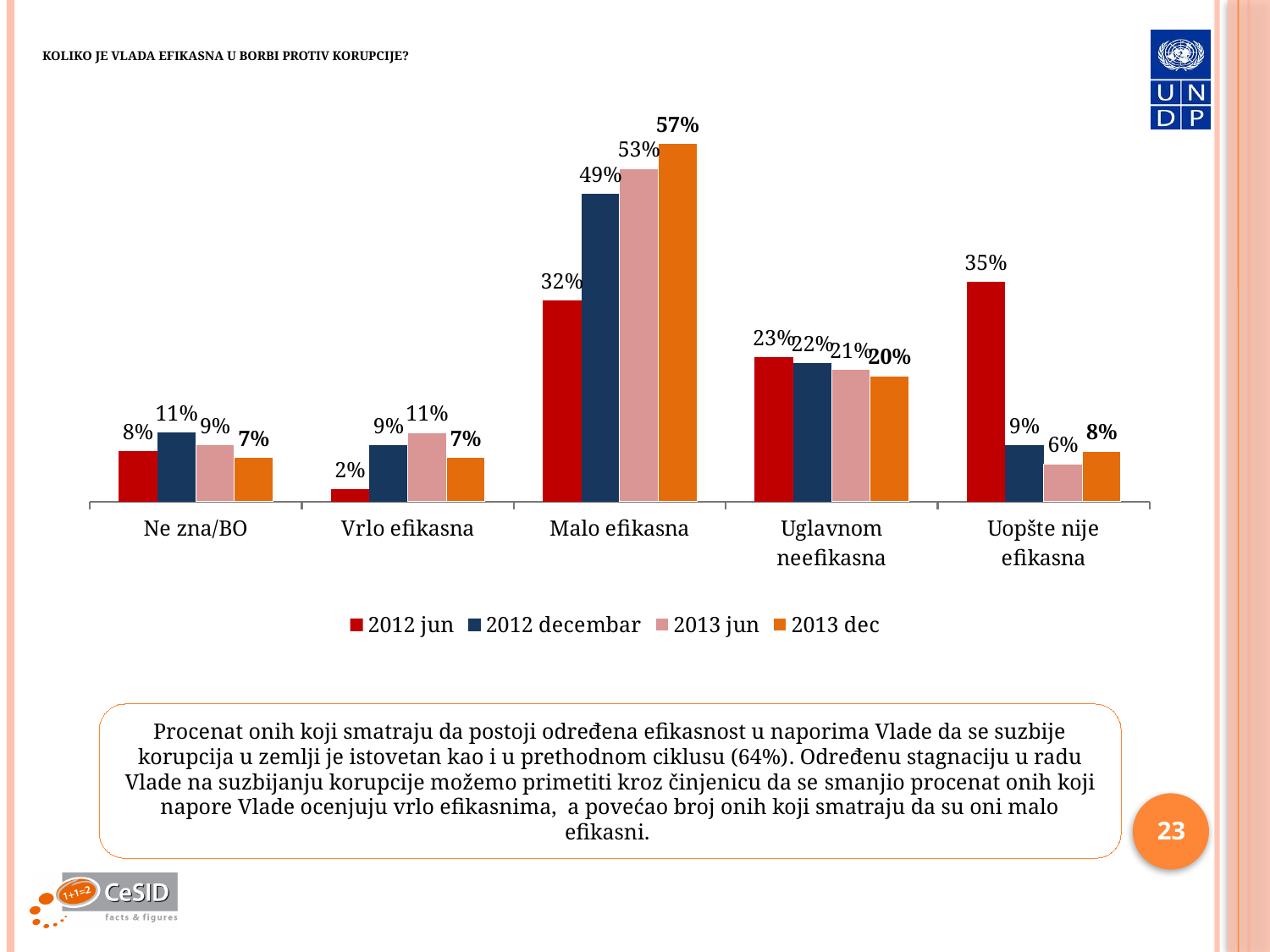
Which category has the highest value in the 2013 dec series? Malo efikasna Do the values for "Malo efikasna" rise or fall from 2012 jun to 2013 dec? Rise What is the value for "Uglavnom neefikasna" in the 2013 jun series? 21% What is the difference between the 2013 dec and 2012 jun values for "Malo efikasna"? 25% How many categories are shown on the x axis? 5 What kind of chart is shown on the slide? Bar chart What is the value for "Uopšte nije efikasna" in the 2012 jun series? 35% Which category has the lowest value in the 2012 jun series? Vrlo efikasna Which is larger for "Uopšte nije efikasna": the 2012 jun value or the 2013 jun value? 2012 jun What is the value for "Malo efikasna" in the 2013 dec series? 57% How many series does the legend list? 4 What is the value for "Vrlo efikasna" in the 2012 jun series? 2%